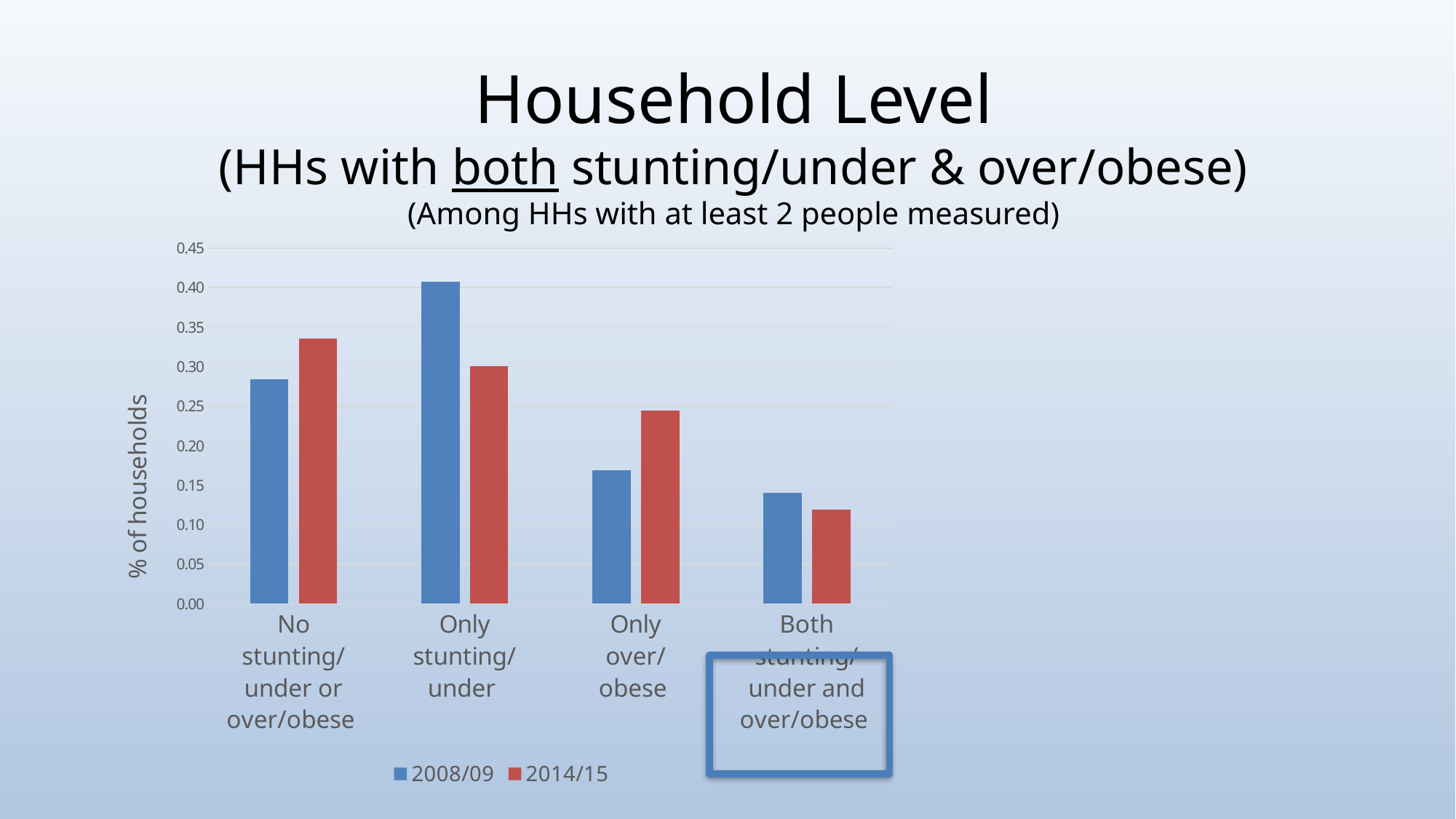
Is the 2014/15 value for Only over/obese greater or less than 0.20? greater How many categories are shown on the x axis? 4 What kind of chart is shown on the slide? bar chart Which category has the lowest 2008/09 value? Both stunting/under and over/obese How many series does the legend list? 2 Is the 2008/09 value for Only stunting/under greater or less than 0.40? greater What is the label of the y axis? % of households Is the 2014/15 value for Both stunting/under and over/obese greater or less than 0.15? less Which category has the highest 2008/09 value? Only stunting/under Which category has the lowest 2014/15 value? Both stunting/under and over/obese For No stunting/under or over/obese, which series has the larger value, 2008/09 or 2014/15? 2014/15 For Only stunting/under, which series has the larger value, 2008/09 or 2014/15? 2008/09